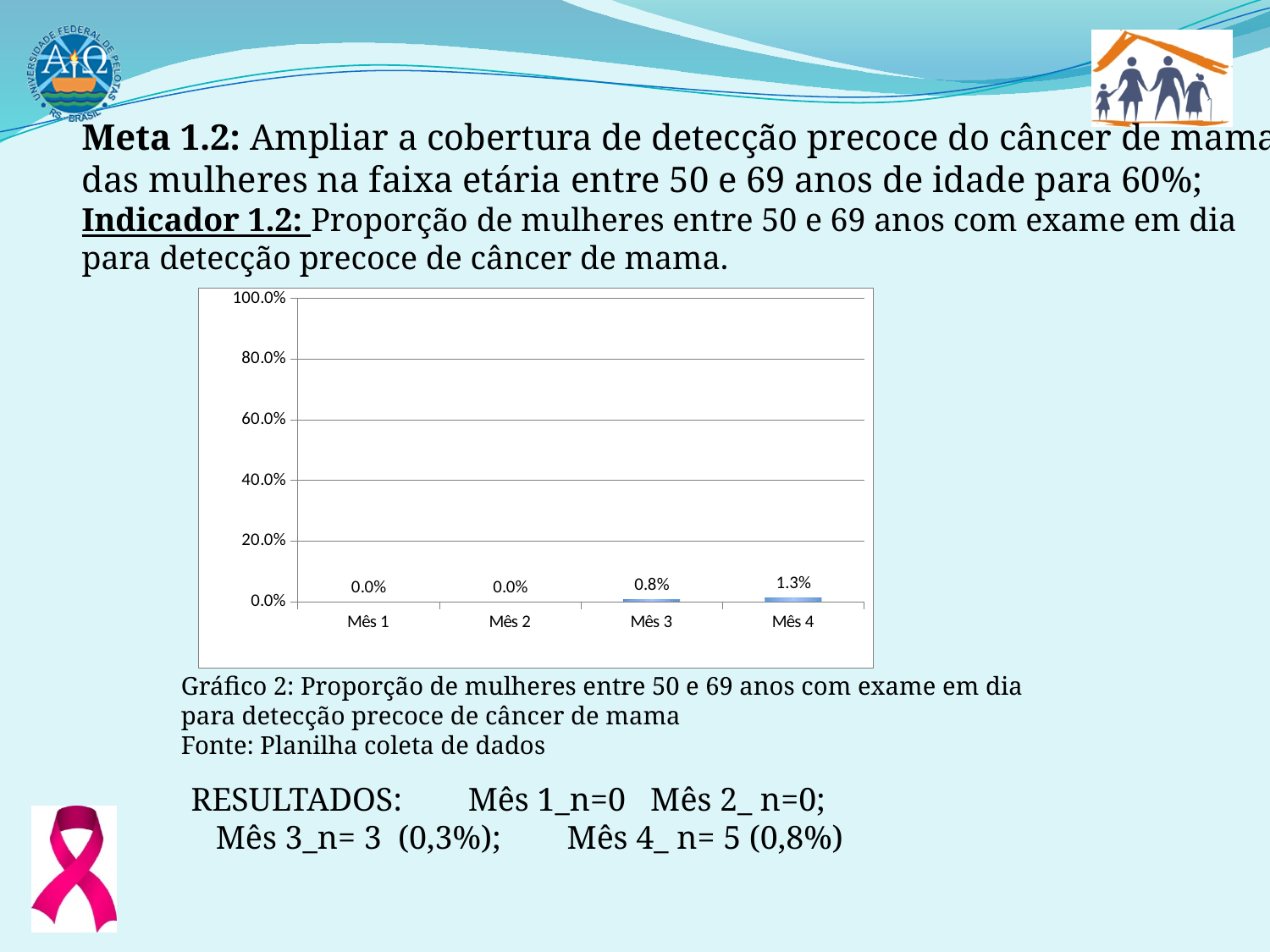
What is the value for Mês 4? 1.3% Do the values rise or fall from Mês 1 to Mês 4? rise Which month has the highest value? Mês 4 What is the highest tick value shown on the y axis? 100.0% What is the value for Mês 3? 0.8% What kind of chart is shown on the slide? bar chart What is the value for Mês 1? 0.0% How many categories are shown on the x axis? 4 What is the difference between the values for Mês 4 and Mês 3? 0.5% Which is larger, the value for Mês 3 or the value for Mês 4? Mês 4 Is the value for Mês 4 greater or less than 20.0%? less What is the value for Mês 2? 0.0%